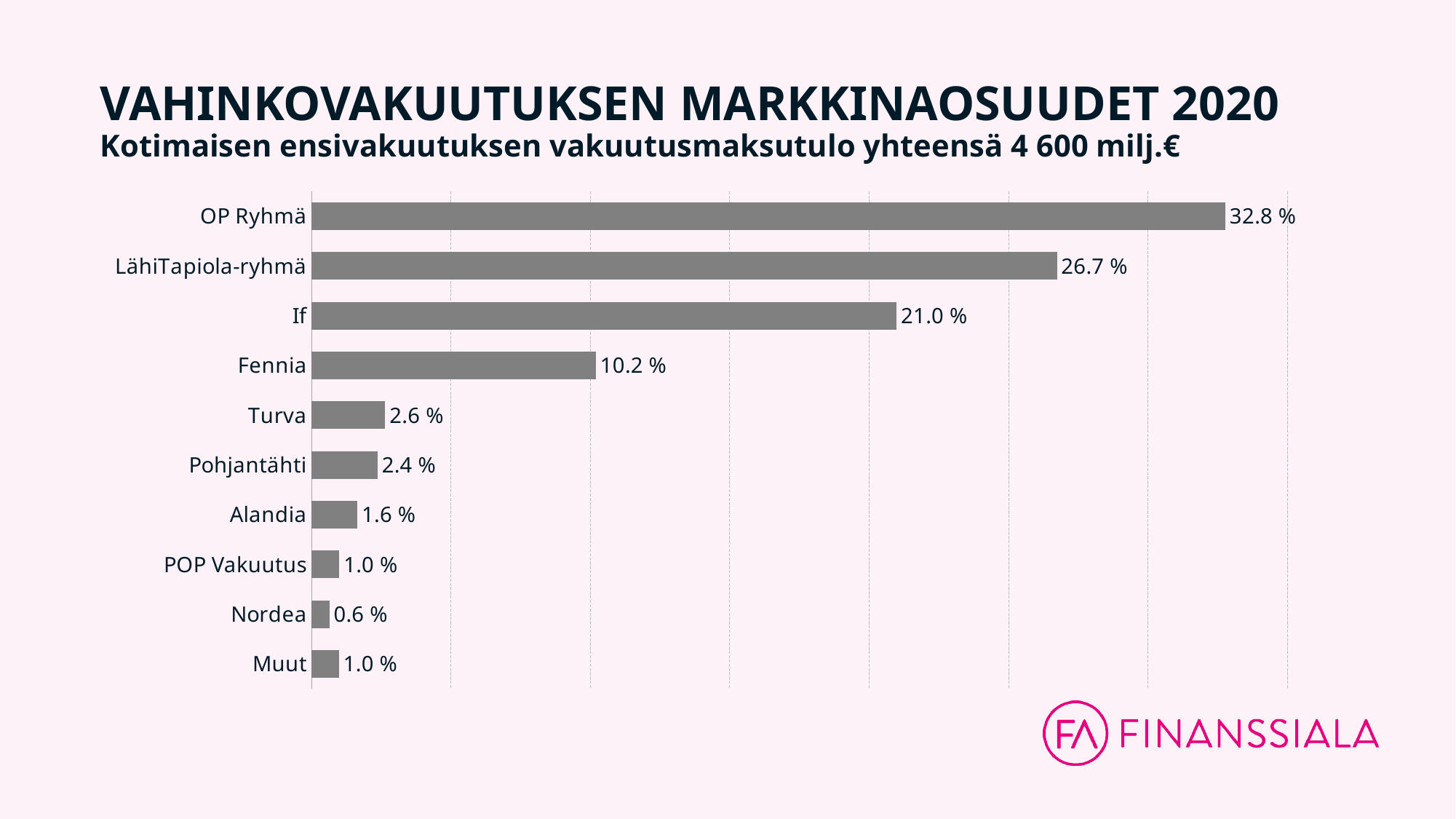
Which has a larger market share, Turva or Pohjantähti? Turva How many categories are shown in the chart? 10 Which category has the highest market share? OP Ryhmä What is the market share shown for Alandia? 1.6 % What is the difference in market share between OP Ryhmä and LähiTapiola-ryhmä? 6.1 % Which has a larger market share, LähiTapiola-ryhmä or If? LähiTapiola-ryhmä What is the market share shown for OP Ryhmä? 32.8 % What is the market share shown for Fennia? 10.2 % What kind of chart is shown on the slide? Bar chart What is the title of the chart? VAHINKOVAKUUTUKSEN MARKKINAOSUUDET 2020 Which category has the lowest market share? Nordea What is the difference in market share between If and Fennia? 10.8 %